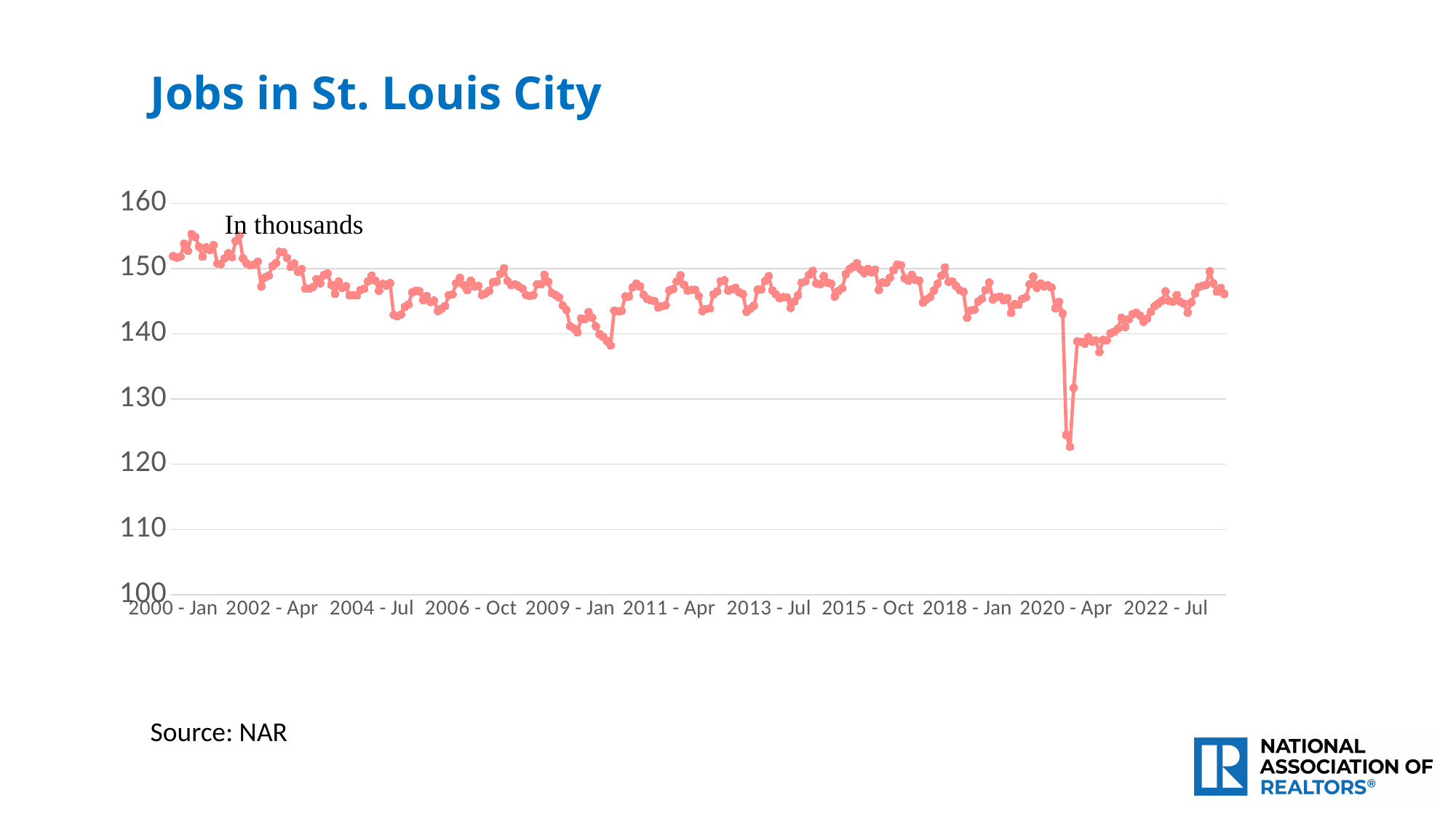
In which year does the series reach its lowest point? 2020 Is the value for 2022 - Jul greater or less than 140? greater In what units are the values on the chart expressed? In thousands Which is larger, the value for 2000 - Jan or the value for 2020 - Apr? 2000 - Jan Is the value for 2020 - Apr greater or less than 130? less What is the title of the chart? Jobs in St. Louis City Does the series ever fall below 120 on the chart? No Do the values rise or fall between 2020 - Apr and 2022 - Jul? rise What kind of chart is shown on the slide? line chart